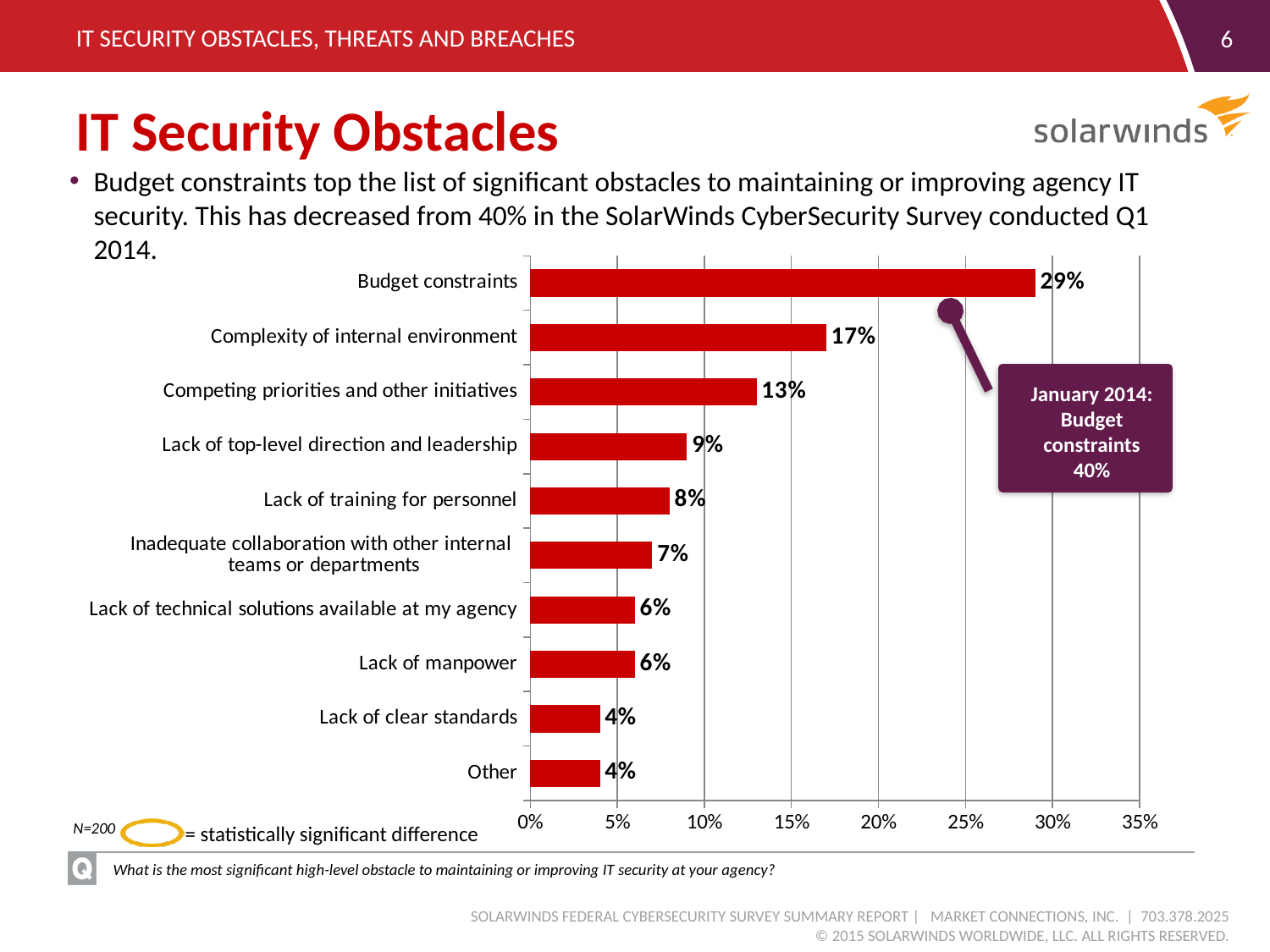
Is the value for Budget constraints greater or less than 25%? greater What type of chart is used on this slide? Bar chart How many obstacle categories are shown in the bar chart? 10 What is the difference between the values for Budget constraints and Complexity of internal environment? 12% What is the difference between Competing priorities and other initiatives and Lack of top-level direction and leadership? 4% What is the maximum value shown on the horizontal axis of the chart? 35% According to the callout, what was the value for Budget constraints in January 2014? 40% What percentage of respondents cited Budget constraints as the most significant obstacle? 29% Which is larger: the value for Lack of training for personnel or the value for Inadequate collaboration with other internal teams or departments? Lack of training for personnel What is the value shown for Complexity of internal environment? 17% What is the value shown for Lack of training for personnel? 8% Which obstacle has the highest percentage in the chart? Budget constraints